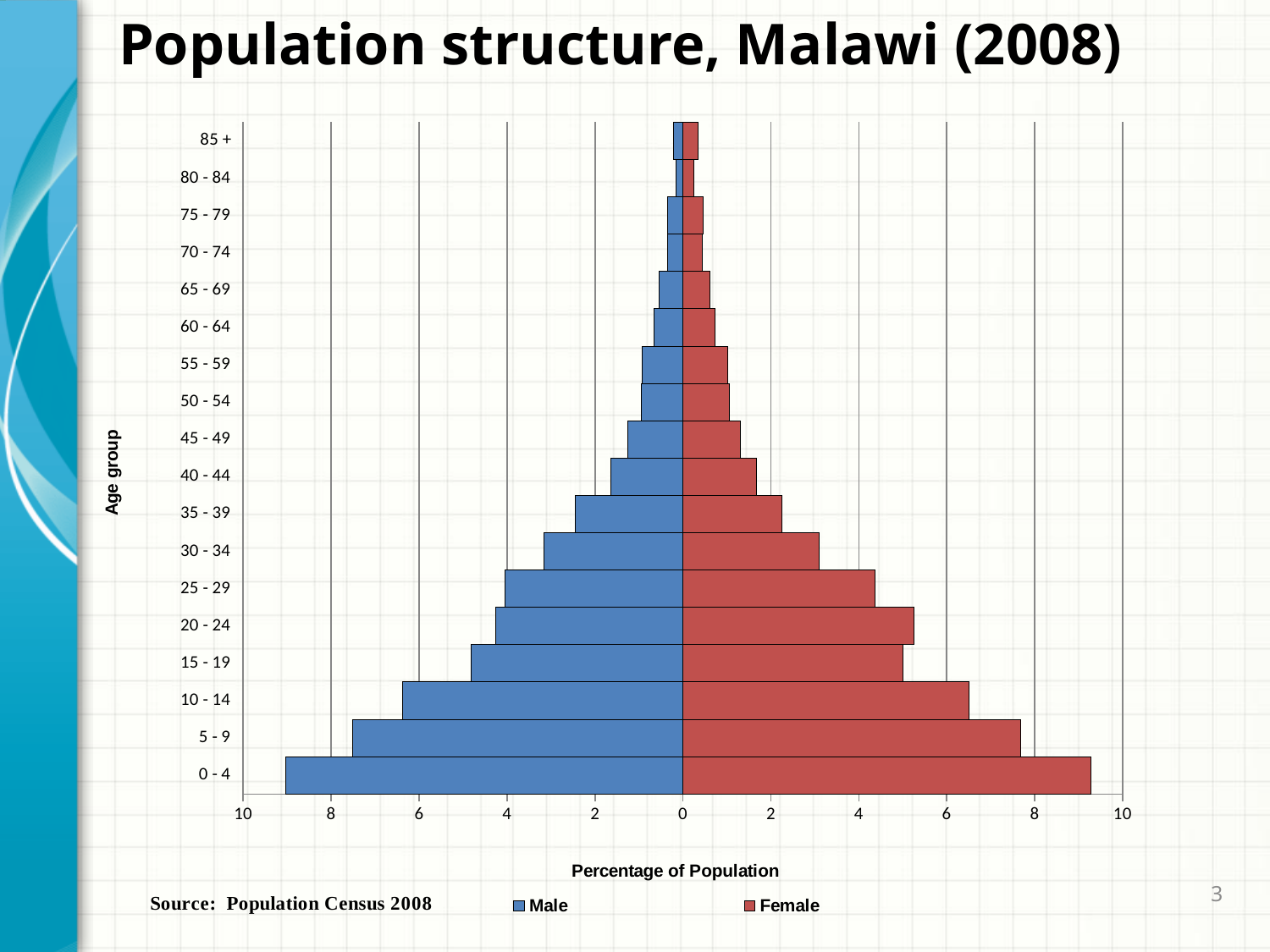
Which colour represents the Female series? red Is the Male value for the 15 - 19 age group greater or less than 6? less Which age group has the highest percentage for the Male series? 0 - 4 How many series does the legend list? 2 Which is larger for the Male series: the 5 - 9 age group or the 10 - 14 age group? 5 - 9 Is the Female value for the 10 - 14 age group greater or less than 6? greater Is the Female value for the 40 - 44 age group greater or less than 2? less What kind of chart is shown on the slide? bar chart Which age group has the highest percentage for the Female series? 0 - 4 How many age groups are shown on the vertical axis? 18 As the age group increases from 0 - 4 to 85 +, do the bars generally get longer or shorter? shorter